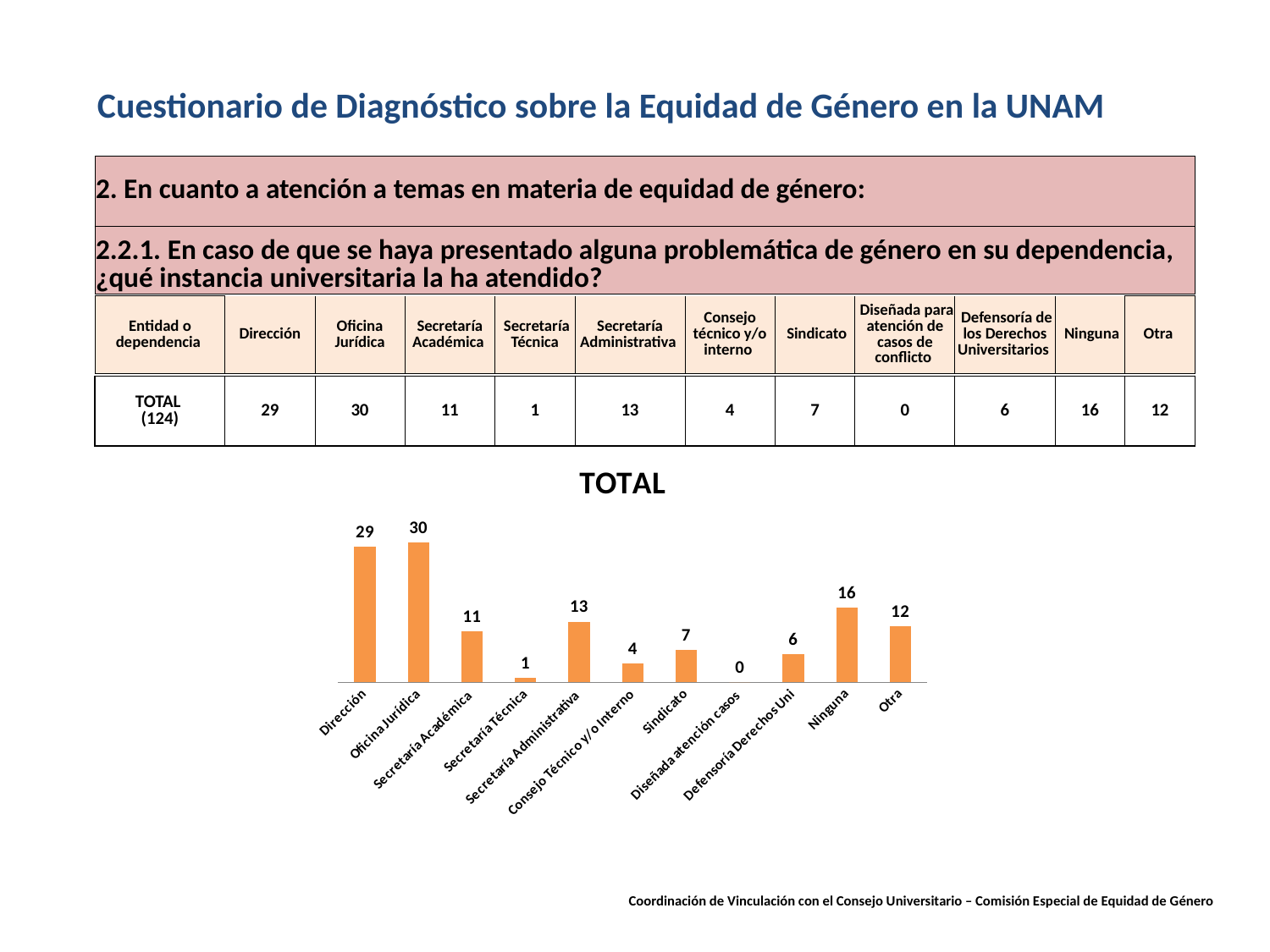
What is the difference between the values for Dirección and Secretaría Académica in the TOTAL chart? 18 What kind of chart is the TOTAL chart? Bar chart What is the value for Ninguna in the TOTAL chart? 16 Which category has the lowest value in the TOTAL chart? Diseñada atención casos Which is larger in the TOTAL chart, Sindicato or Otra? Otra What is the value for Secretaría Técnica in the TOTAL chart? 1 Which category has the highest value in the TOTAL chart? Oficina Jurídica What is the difference between the values for Ninguna and Otra in the TOTAL chart? 4 What is the title of the chart on the slide? TOTAL What is the value for Secretaría Administrativa in the TOTAL chart? 13 How many categories are shown in the TOTAL chart? 11 What is the value for Oficina Jurídica in the TOTAL chart? 30